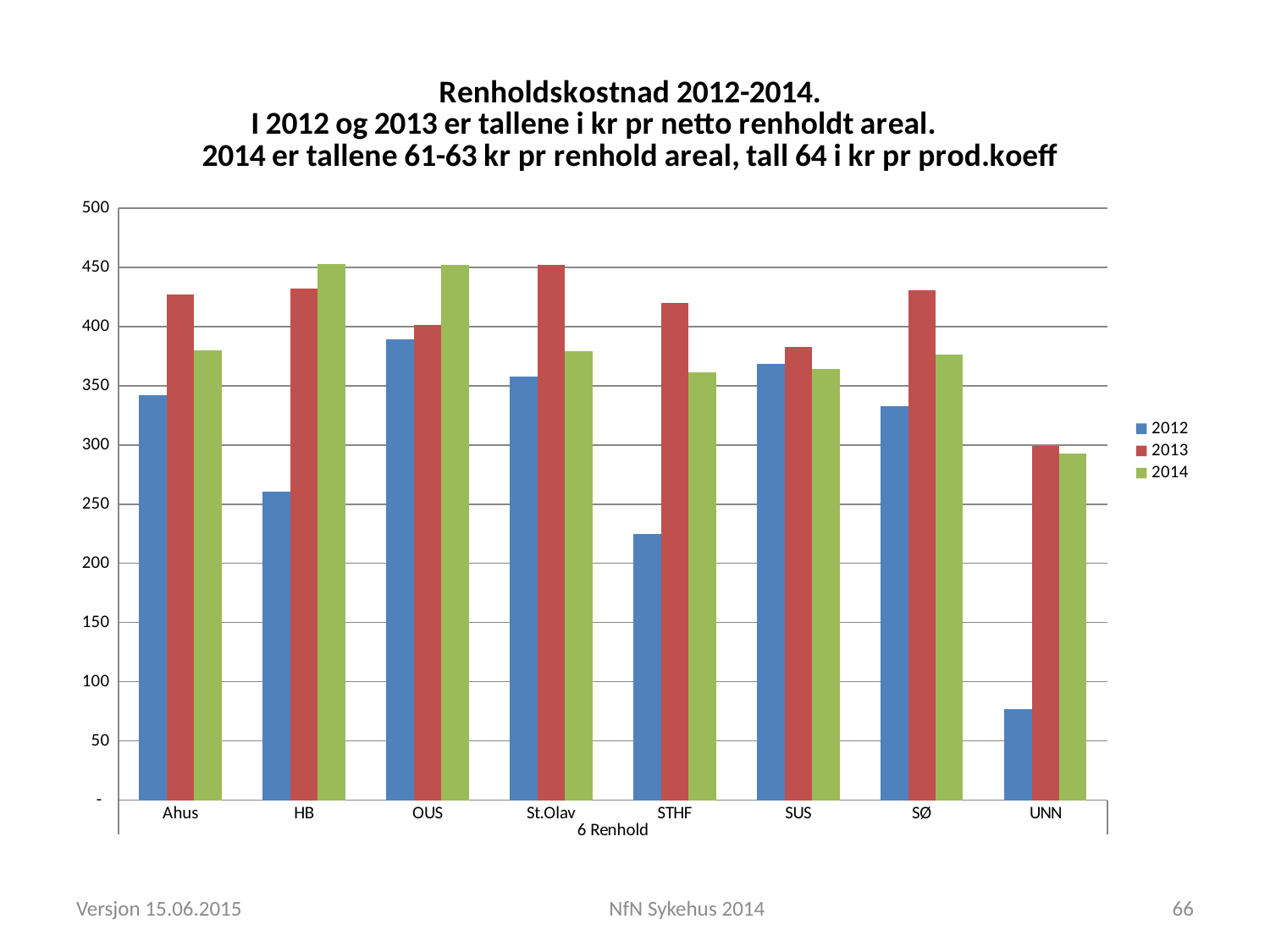
For Ahus, which is larger: the 2013 value or the 2014 value? 2013 Which hospital has the lowest value for 2012? UNN What label appears below the category axis? 6 Renhold How many series does the legend list? 3 How many hospitals (categories) are shown on the x axis? 8 What kind of chart is shown on the slide? bar chart Which hospital has the highest value for 2013? St.Olav Is the 2013 value for Ahus greater or less than 400? greater Is the 2012 value for STHF greater or less than 250? less For HB, which is larger: the 2012 value or the 2013 value? 2013 Which hospital has the lowest value for 2014? UNN Is the 2012 value for UNN greater or less than 100? less